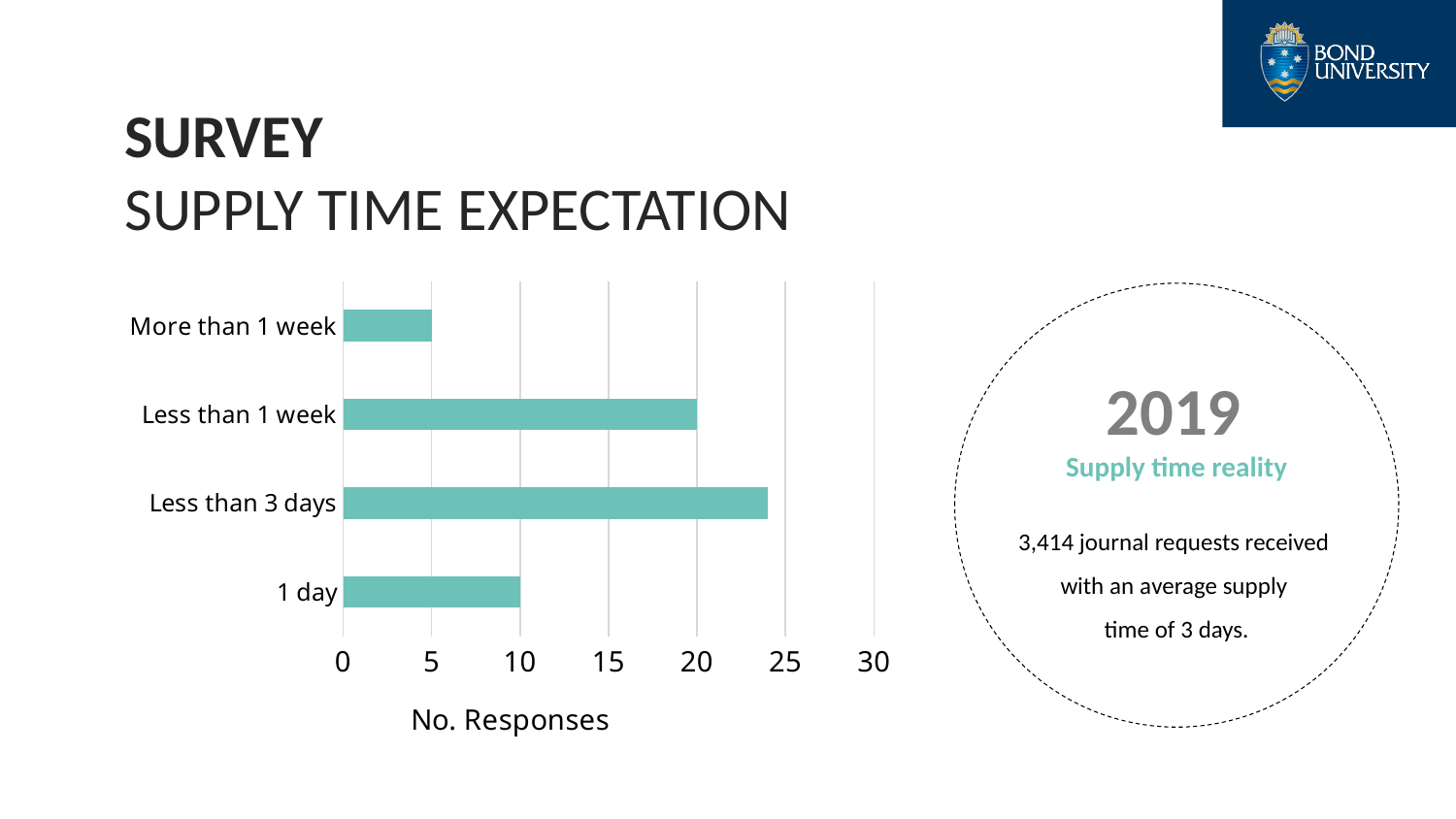
What kind of chart is shown on the slide? bar chart What is the number of responses for '1 day'? 10 How many categories are shown in the bar chart? 4 Which has more responses, 'Less than 1 week' or '1 day'? Less than 1 week What is the number of responses for 'More than 1 week'? 5 Which category has the lowest number of responses? More than 1 week What is the number of responses for 'Less than 1 week'? 20 What is the label of the horizontal axis of the chart? No. Responses What is the difference in responses between 'Less than 1 week' and 'More than 1 week'? 15 Is the value for 'Less than 3 days' greater or less than 20? greater Which category has the highest number of responses? Less than 3 days Is the value for 'Less than 3 days' greater or less than 25? less